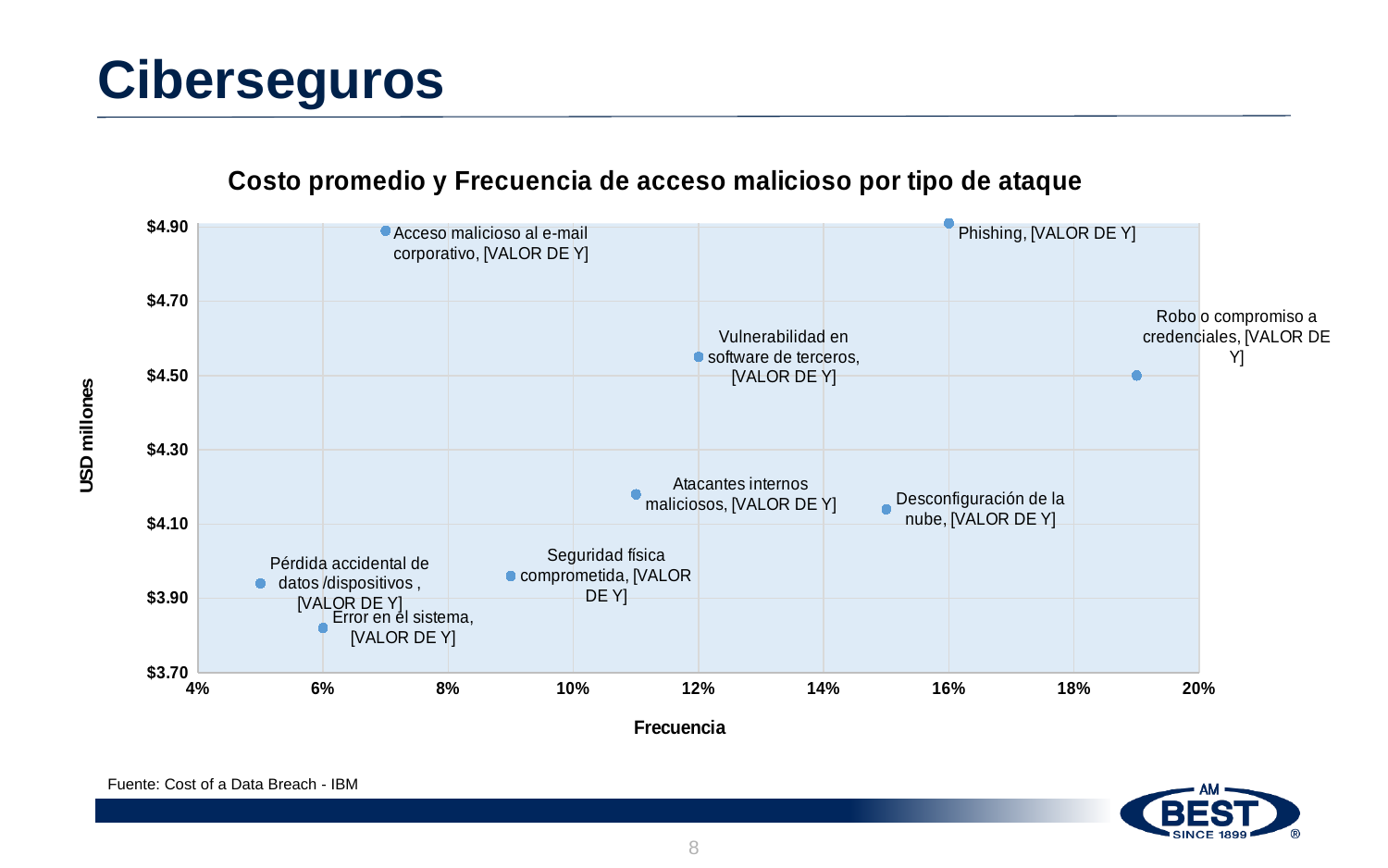
Which has a higher average cost, Seguridad física comprometida or Error en el sistema? Seguridad física comprometida How many attack types are plotted in the chart? 9 What is the frequency for Vulnerabilidad en software de terceros? 12% What is the label of the vertical axis? USD millones What is the average cost in USD millones for Robo o compromiso a credenciales? $4.50 What is the frequency for Phishing? 16% Which attack type has the lowest average cost? Error en el sistema What is the title of the chart? Costo promedio y Frecuencia de acceso malicioso por tipo de ataque Is the average cost for Desconfiguración de la nube greater or less than $4.30? less Which attack type has the lowest frequency (furthest left on the x axis)? Pérdida accidental de datos /dispositivos What kind of chart is shown on the slide? scatter chart Which attack type has the highest frequency (furthest right on the x axis)? Robo o compromiso a credenciales